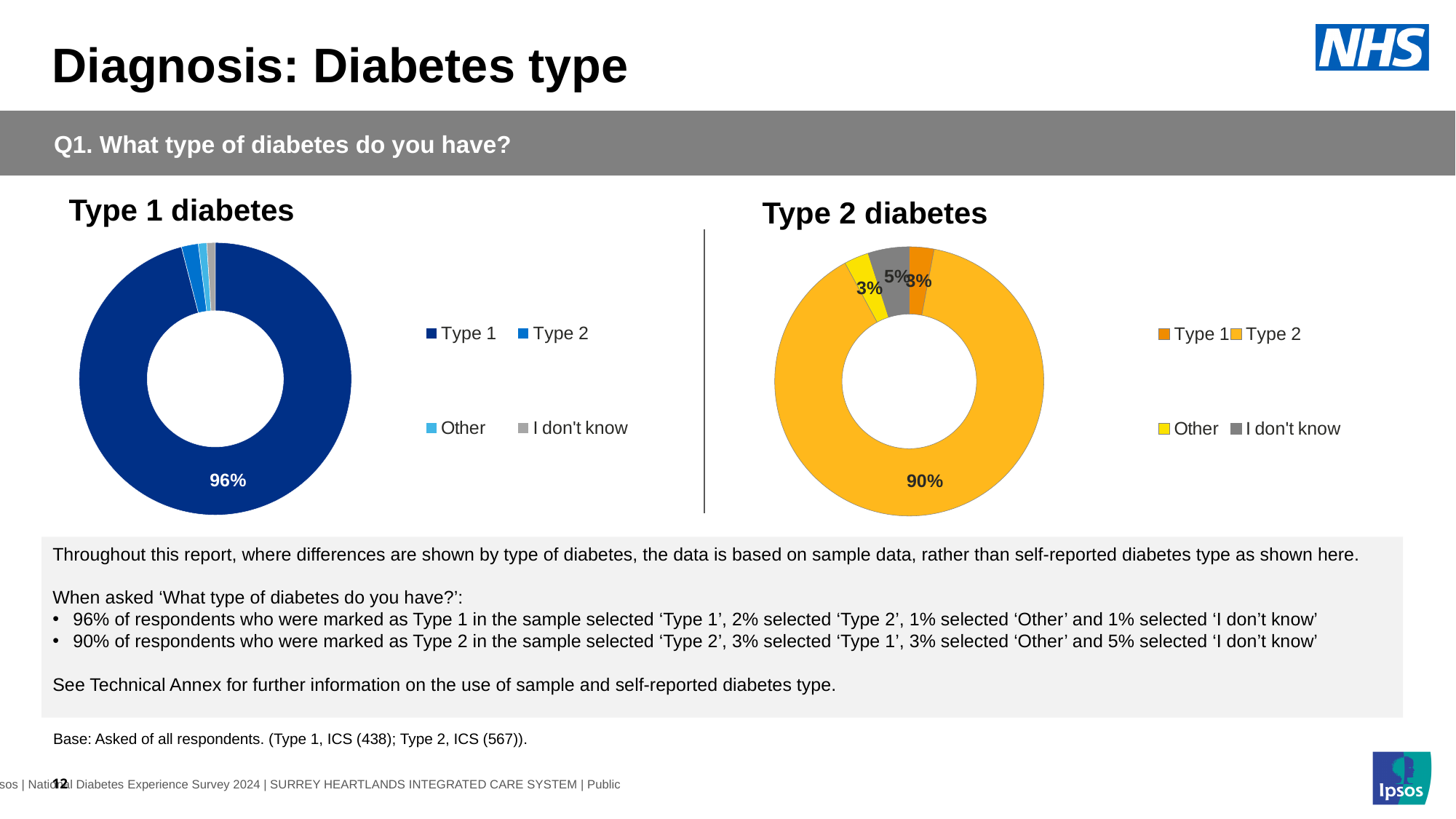
In the Type 2 diabetes chart, what share of respondents selected 'I don't know'? 5% In the Type 1 diabetes chart, what share of respondents selected 'Type 1'? 96% In the Type 2 diabetes chart, which is larger: the 'Other' slice or the 'I don't know' slice? I don't know In the Type 2 diabetes chart, what share of respondents selected 'Other'? 3% How many categories does the legend of the Type 2 diabetes chart list? 4 In the Type 2 diabetes chart, what is the difference between the 'Type 2' share and the 'I don't know' share? 85 percentage points In the Type 2 diabetes chart, which category has the largest slice? Type 2 In the Type 2 diabetes chart, what share of respondents selected 'Type 2'? 90% In the Type 1 diabetes chart, which category has the largest slice? Type 1 What is the difference between the 'Type 1' share in the Type 1 diabetes chart and the 'Type 2' share in the Type 2 diabetes chart? 6 percentage points What kind of chart is used for the Type 1 diabetes data? Donut (pie) chart In the Type 1 diabetes chart, what colour is the 'Type 1' slice? Dark blue